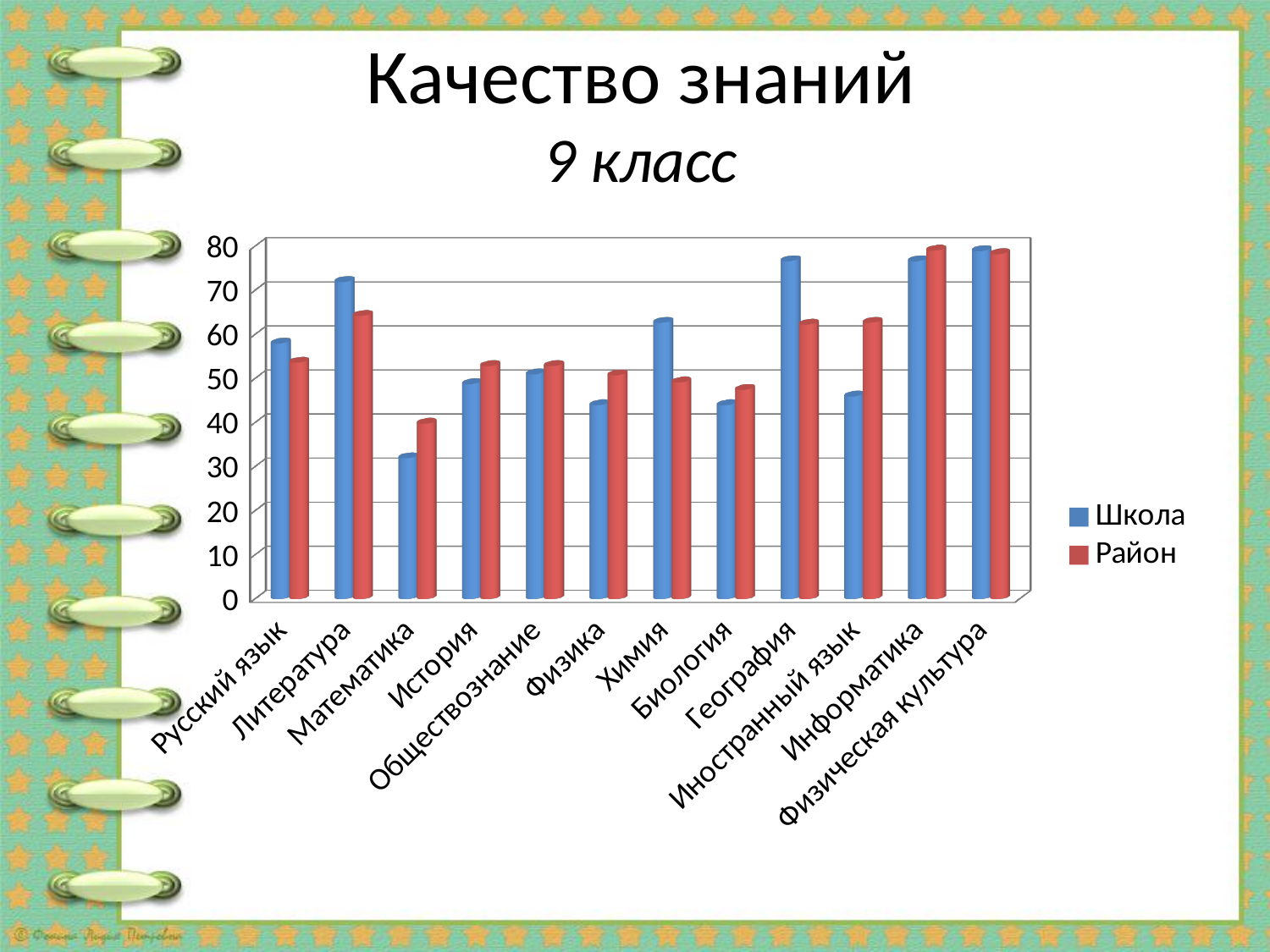
Is the Район value for Иностранный язык greater or less than 60? greater What kind of chart is shown on the slide? bar chart Which subject has the lowest value for Район? Математика Which subject has the lowest value for Школа? Математика For Иностранный язык, which is larger: Школа or Район? Район Is the Школа value for Математика greater or less than 40? less How many series does the legend list? 2 What are the two legend entries of the chart? Школа and Район How many subjects (categories) are shown on the x axis? 12 Is the Школа value for Физика greater or less than 50? less For География, which is larger: Школа or Район? Школа